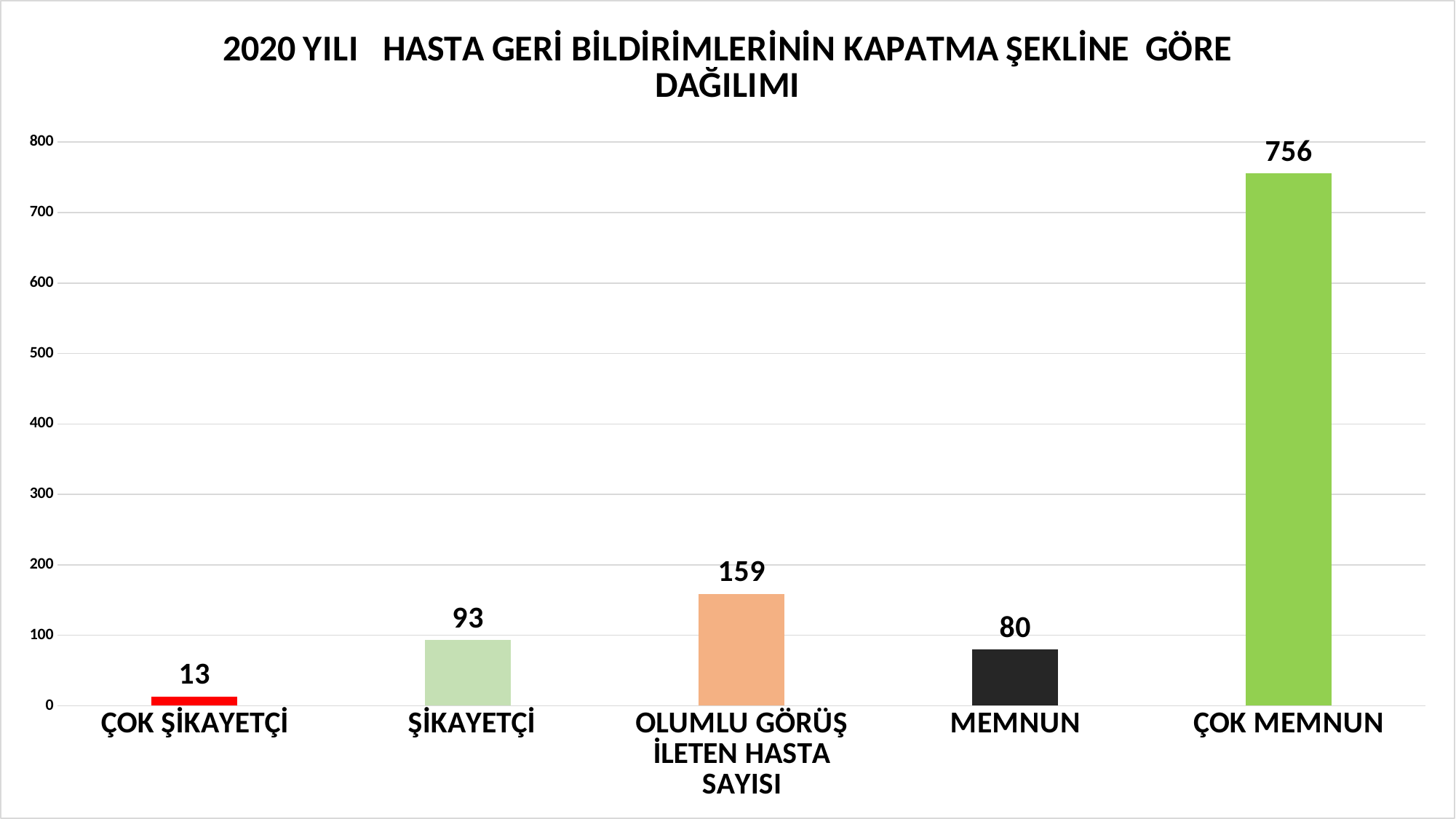
Is the value for OLUMLU GÖRÜŞ İLETEN HASTA SAYISI greater or less than 200? less What is the difference between the values for ŞİKAYETÇİ and ÇOK ŞİKAYETÇİ? 80 What is the difference between the values for ÇOK MEMNUN and OLUMLU GÖRÜŞ İLETEN HASTA SAYISI? 597 What kind of chart is shown on the slide? bar chart What is the value for MEMNUN? 80 Which is larger, the value for ŞİKAYETÇİ or the value for MEMNUN? ŞİKAYETÇİ What is the value for ŞİKAYETÇİ? 93 Which category has the lowest value? ÇOK ŞİKAYETÇİ Which category has the highest value? ÇOK MEMNUN What is the value for ÇOK MEMNUN? 756 What is the value for OLUMLU GÖRÜŞ İLETEN HASTA SAYISI? 159 How many categories are shown on the x axis? 5